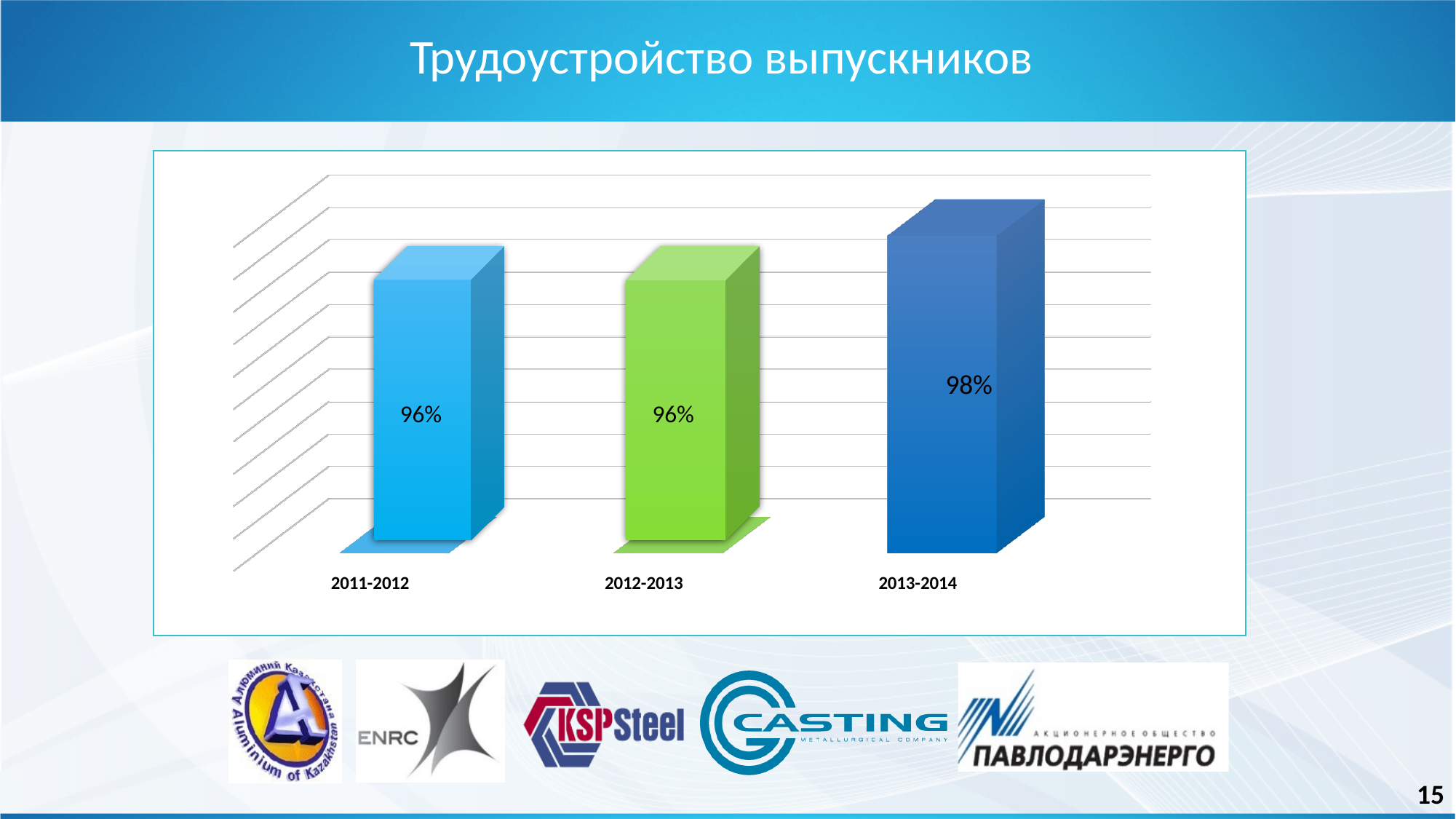
What is the value for 2013-2014? 98% What is the title of the slide? Трудоустройство выпускников Do the values rise or fall from 2011-2012 to 2013-2014? rise How many periods are shown on the x axis? 3 What kind of chart is shown on the slide? bar chart What is the value for 2012-2013? 96% What is the value for 2011-2012? 96% What is the difference between the values for 2013-2014 and 2012-2013? 2% Which is larger, the value for 2013-2014 or the value for 2011-2012? 2013-2014 Which period has the highest value? 2013-2014 What colour is the bar for 2012-2013? green